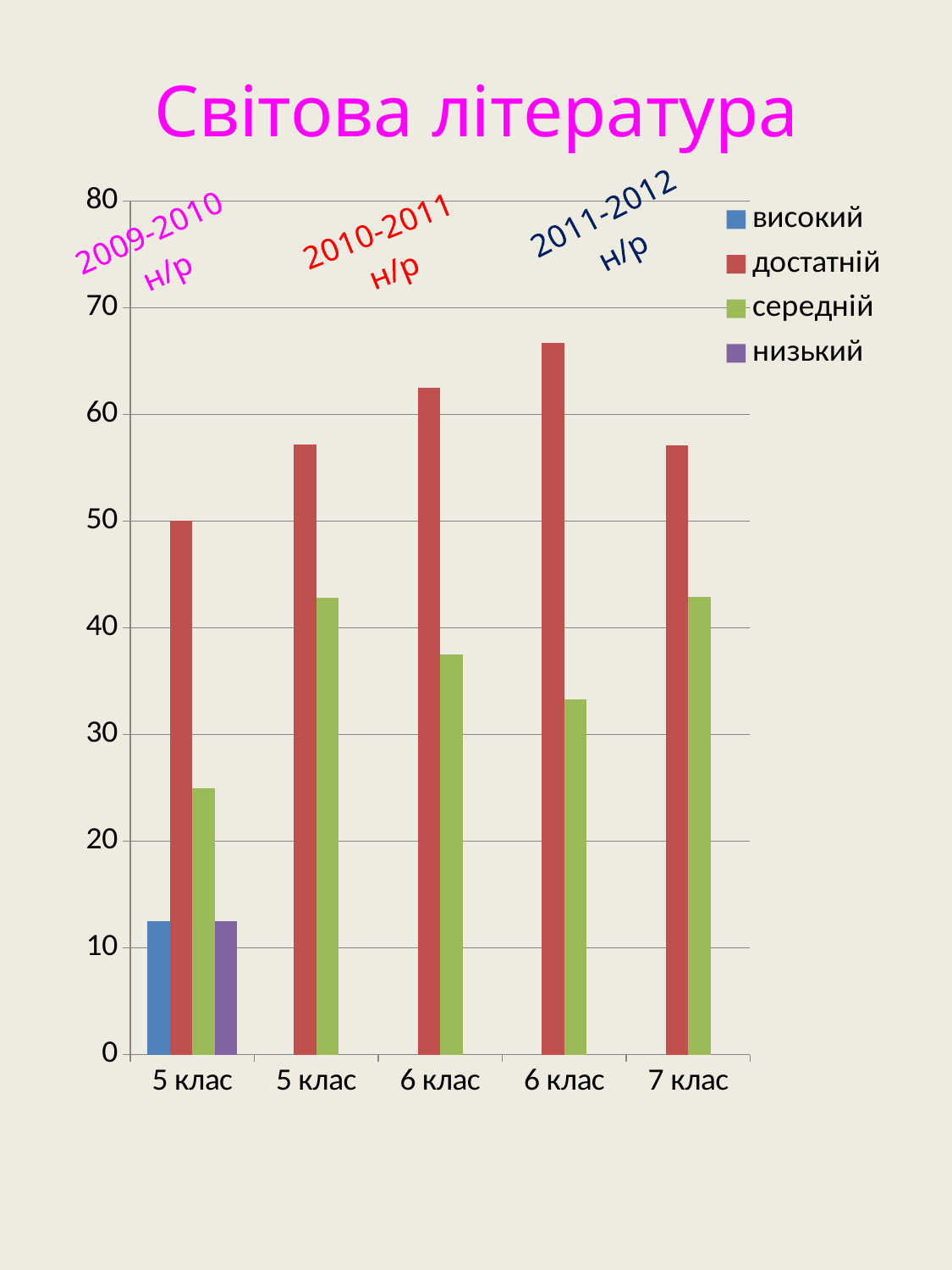
What is the value of достатній for the first 5 клас category (2009-2010 н/р)? 50 Which category has the lowest середній bar? 5 клас (2009-2010 н/р) Which category has the highest достатній bar? 6 клас (2011-2012 н/р) Which series is shown in red in the legend? достатній What is the title of the chart? Світова література How many categories are shown along the x axis? 5 How many series does the legend list? 4 Is the value of достатній for the 6 клас category in 2011-2012 н/р greater or less than 60? greater What kind of chart is shown on the slide? bar chart Is the value of високий for the first 5 клас category (2009-2010 н/р) greater or less than 20? less For 7 клас, which is larger: достатній or середній? достатній Is the value of середній for the first 5 клас category (2009-2010 н/р) greater or less than 30? less